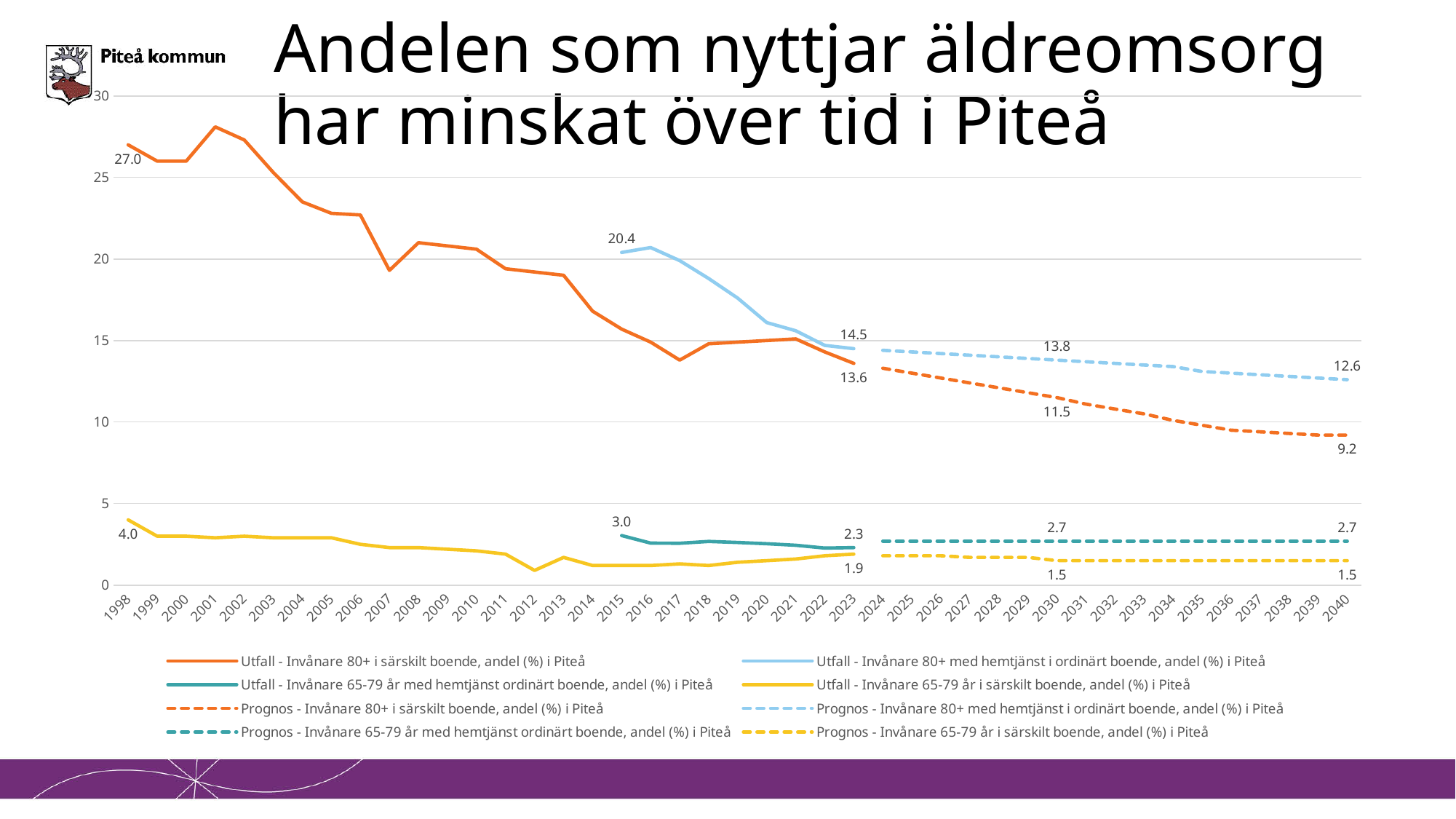
What is the value for 'Prognos - Invånare 80+ i särskilt boende' in 2040? 9.2 What is the difference between the 2015 and 2023 values for 'Utfall - Invånare 80+ med hemtjänst i ordinärt boende'? 5.9 What is the value for 'Utfall - Invånare 65-79 år i särskilt boende' in 1998? 4.0 Does the 'Utfall - Invånare 80+ i särskilt boende' series rise or fall from 1998 to 2023? fall How many series does the legend list? 8 Which is larger in 2023: 'Utfall - Invånare 65-79 år med hemtjänst ordinärt boende' or 'Utfall - Invånare 65-79 år i särskilt boende'? Utfall - Invånare 65-79 år med hemtjänst ordinärt boende What is the value for 'Utfall - Invånare 80+ med hemtjänst i ordinärt boende' in 2015? 20.4 What type of chart is shown on the slide? line chart What is the value for 'Prognos - Invånare 80+ med hemtjänst i ordinärt boende' in 2030? 13.8 What is the value for 'Utfall - Invånare 80+ i särskilt boende' in 1998? 27.0 What is the value for 'Utfall - Invånare 80+ i särskilt boende' in 2023? 13.6 Is the value for 'Utfall - Invånare 80+ i särskilt boende' in 2001 greater or less than 25? greater